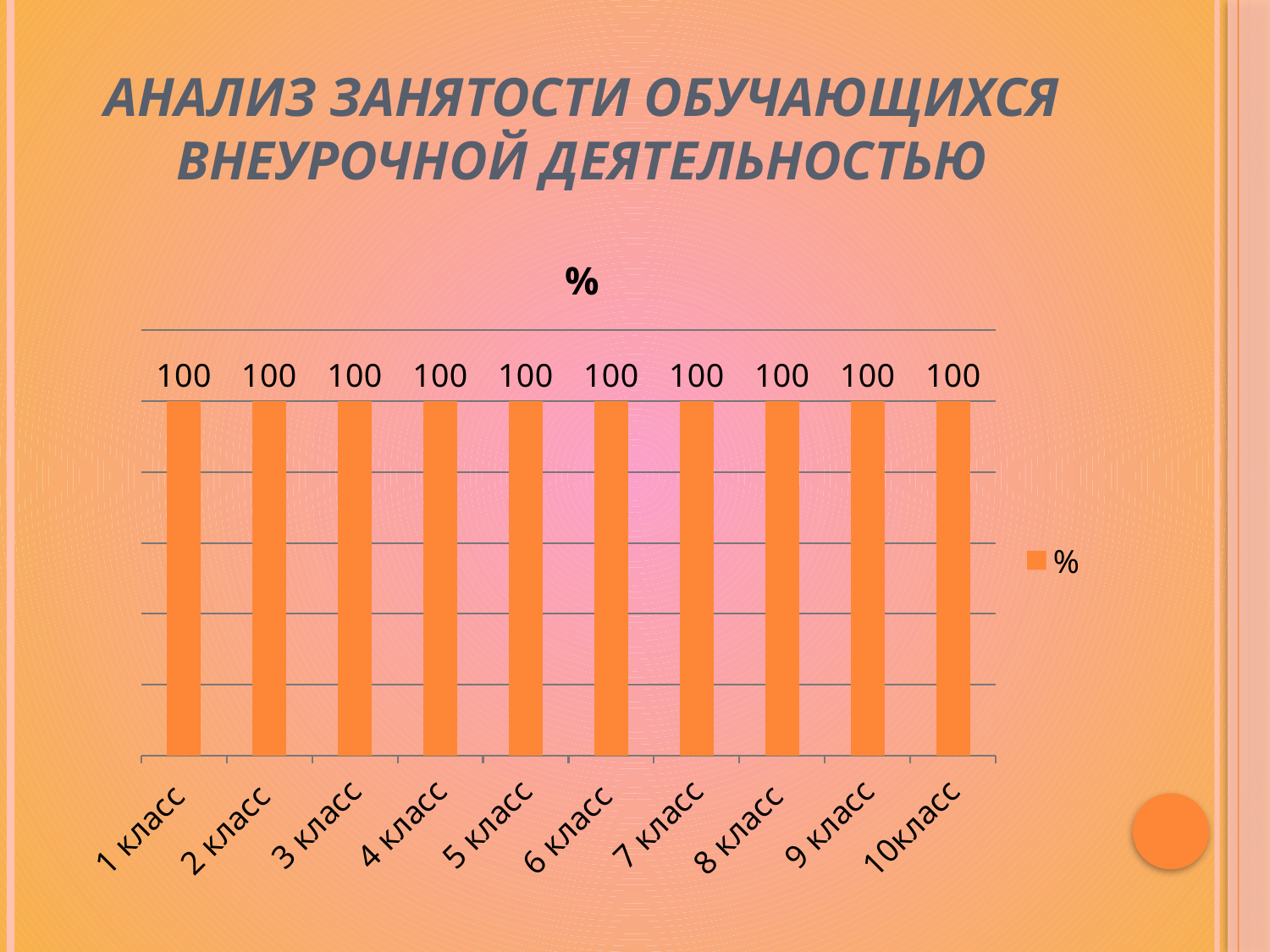
What kind of chart is shown on the slide? bar chart What is the value for 5 класс? 100 What colour are the bars in the chart? orange What is the title of the chart? % What is the value for 1 класс? 100 Do the values rise, fall, or stay flat from 1 класс to 10класс? stay flat How many series does the legend list? 1 How many categories (classes) are shown on the x axis? 10 Is the value for 2 класс larger than, smaller than, or equal to the value for 9 класс? equal What is the value for 7 класс? 100 What is the value for 10класс? 100 What is the difference between the values for 3 класс and 8 класс? 0